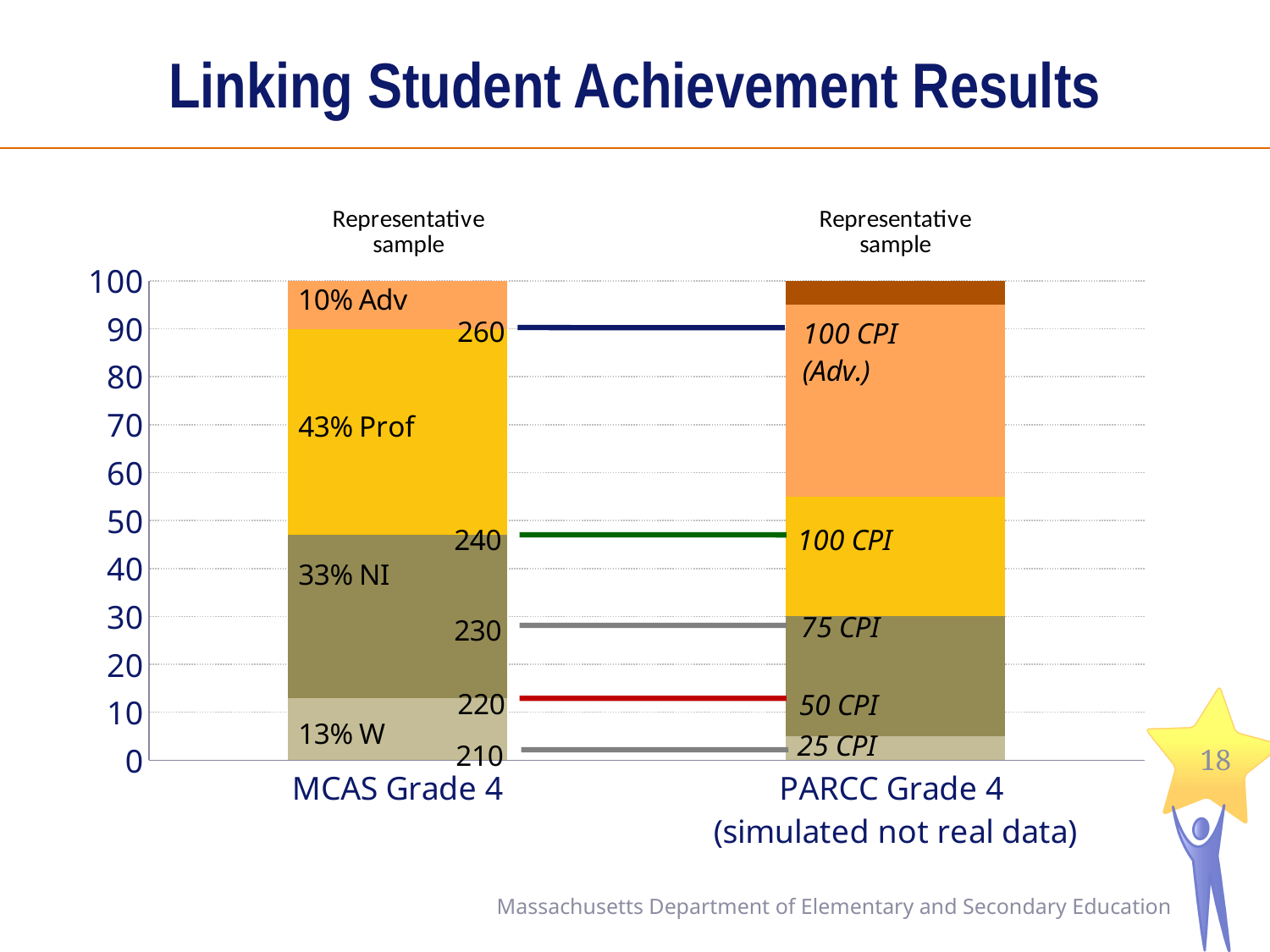
What is the difference between the Proficient and Needs Improvement percentages in the MCAS Grade 4 bar? 10 percentage points What percentage of students are labelled Warning (W) in the MCAS Grade 4 bar? 13% What percentage of students are labelled Proficient (Prof) in the MCAS Grade 4 bar? 43% What percentage of students are labelled Advanced (Adv) in the MCAS Grade 4 bar? 10% Which performance level has the largest share in the MCAS Grade 4 bar? Prof (43%) Which PARCC CPI label is aligned with the MCAS score of 220? 50 CPI How many bars are plotted in the chart? 2 What percentage of students are labelled Needs Improvement (NI) in the MCAS Grade 4 bar? 33% In the MCAS Grade 4 bar, which is larger: the NI share or the W share? NI What is the title of the slide? Linking Student Achievement Results What kind of chart is shown on the slide? Stacked bar chart Which performance level has the smallest share in the MCAS Grade 4 bar? Adv (10%)